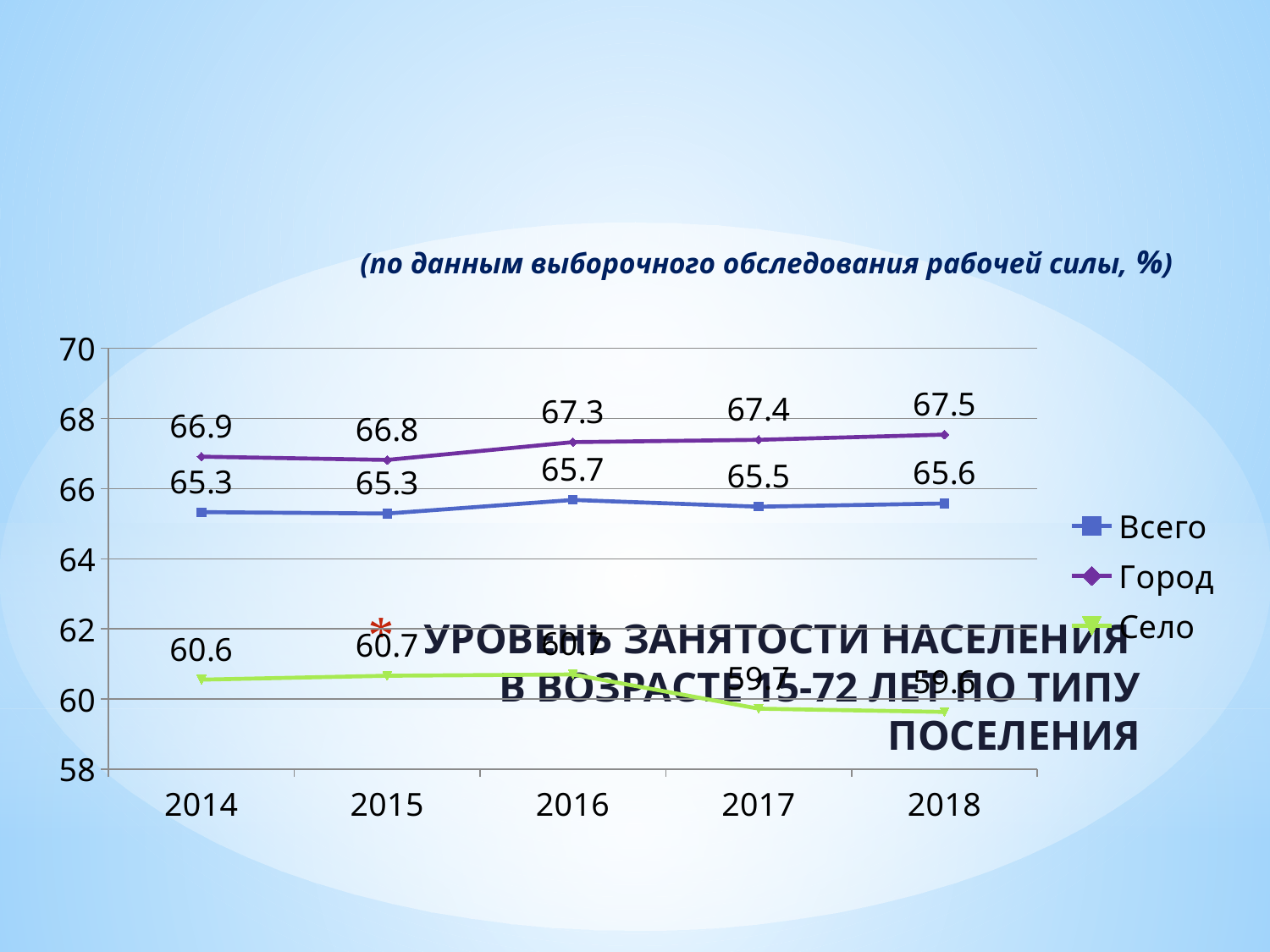
What is the difference between the Всего values in 2016 and 2015? 0.4 What is the value for Город in 2018? 67.5 What is the difference between the Город values in 2018 and 2014? 0.6 In which year is the value for Город the highest? 2018 How many series does the legend list? 3 What is the value for Село in 2014? 60.6 Is the value for Село in 2017 greater or less than 60? less How many years are shown on the x axis? 5 In which year is the value for Город the lowest? 2015 What kind of chart is shown on the slide? line chart Which year has the larger value for Всего, 2016 or 2017? 2016 What is the value for Всего in 2016? 65.7